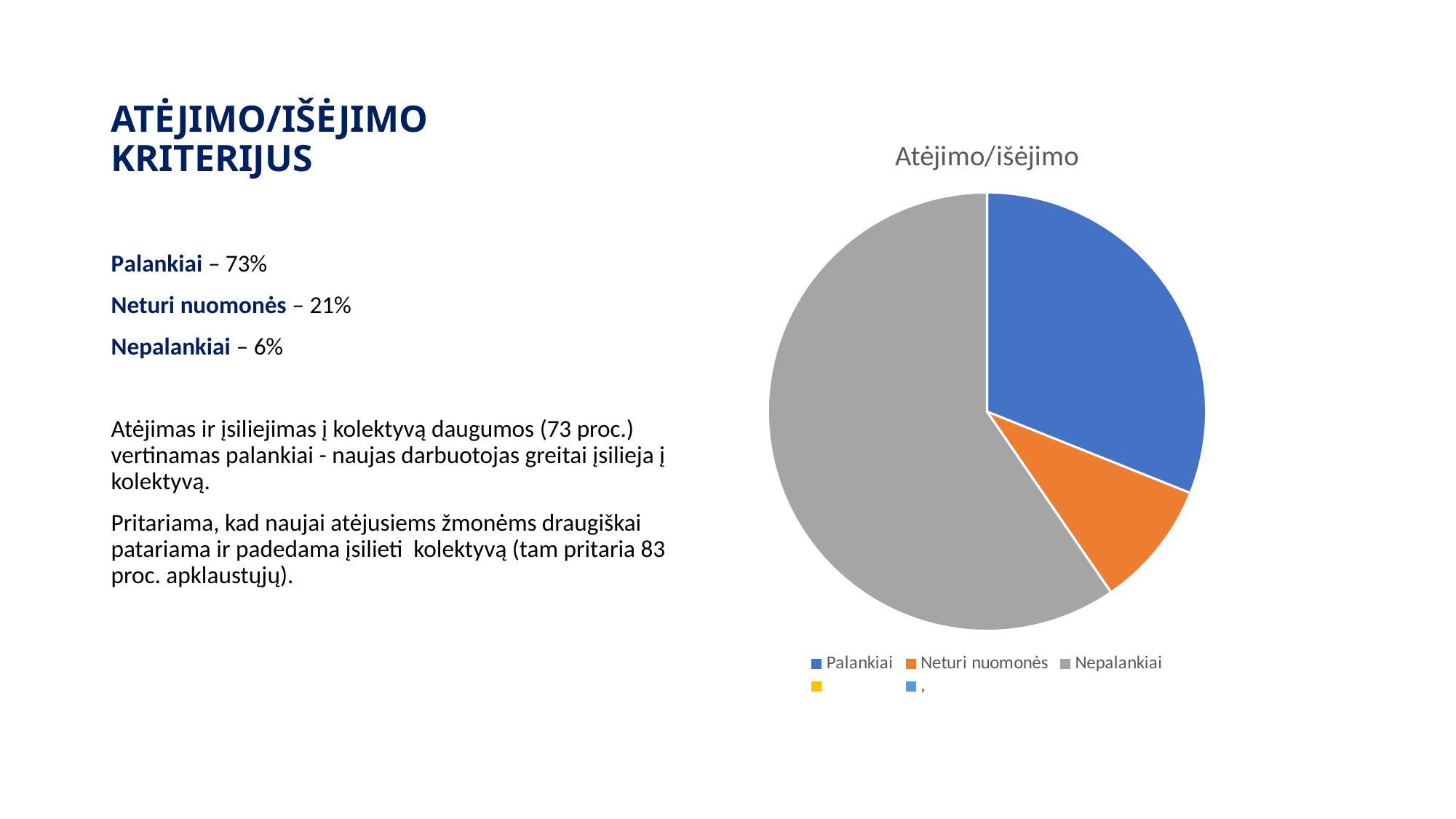
What colour is the Palankiai slice in the pie chart? blue How many slices does the pie chart have? 3 What kind of chart is shown on the slide? pie chart Which slice is larger in the pie chart, Palankiai or Neturi nuomonės? Palankiai Which category has the smallest slice in the pie chart? Neturi nuomonės Which category has the largest slice in the pie chart? Nepalankiai What is the title of the chart? Atėjimo/išėjimo Which slice is larger in the pie chart, Nepalankiai or Palankiai? Nepalankiai